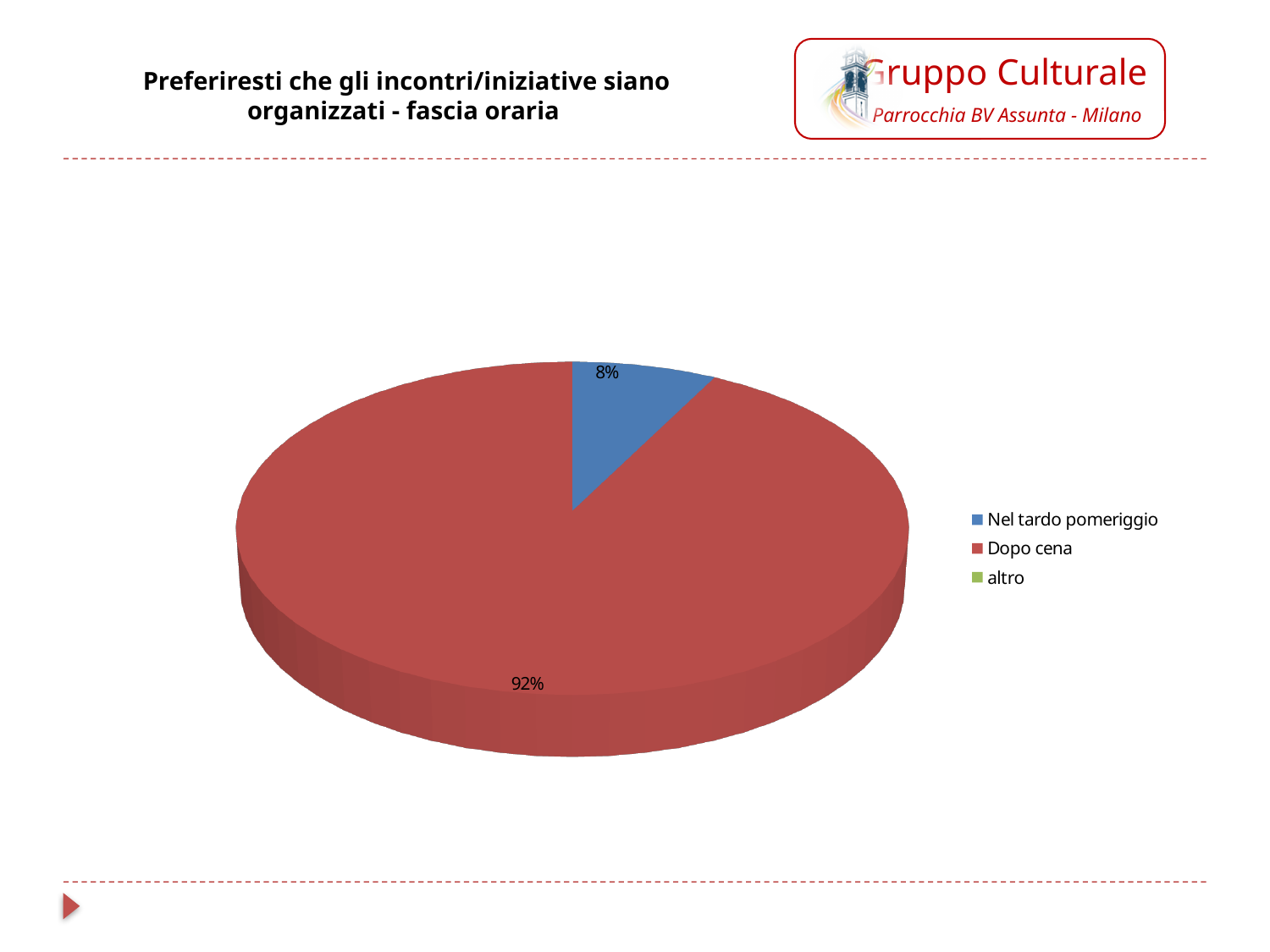
Which category has the largest slice of the pie? Dopo cena What share of the pie does "Nel tardo pomeriggio" have? 8% Which is larger, the share for "Dopo cena" or the share for "Nel tardo pomeriggio"? Dopo cena What share of the pie does "Dopo cena" have? 92% What kind of chart is shown on the slide? pie chart Is the share for "Nel tardo pomeriggio" greater or less than 10%? less What colour is the "Dopo cena" slice? red Is the share for "Dopo cena" greater or less than 50%? greater Which of the two labelled slices is smaller, "Nel tardo pomeriggio" or "Dopo cena"? Nel tardo pomeriggio What colour is the "Nel tardo pomeriggio" slice? blue How many entries does the legend list? 3 What is the difference in percentage points between the "Dopo cena" slice and the "Nel tardo pomeriggio" slice? 84 percentage points